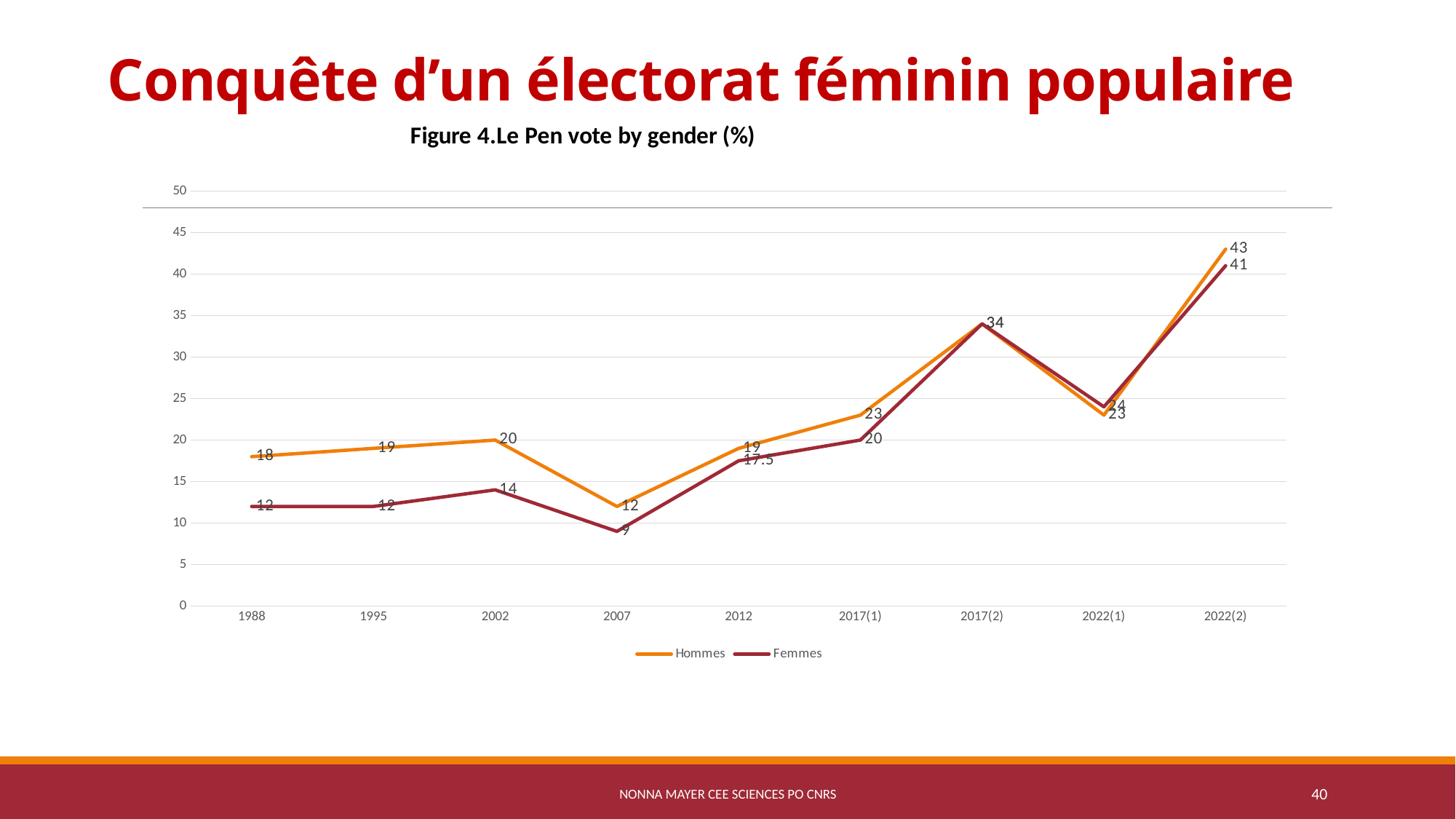
How many series does the legend list? 2 What is the value for Hommes in 1988? 18 What is the difference between the Hommes and Femmes values in 2022(2)? 2 In which year does the Femmes series reach its lowest value? 2007 In which year does the Hommes series reach its highest value? 2022(2) What colour is the Hommes line? Orange What is the value for Femmes in 2012? 17.5 Does the Femmes series rise or fall from 2007 to 2017(2)? Rise How many time points are plotted on the x axis? 9 What kind of chart is shown on the slide? Line chart In 2022(1), which series has the larger value, Hommes or Femmes? Femmes What is the value for Femmes in 2007? 9